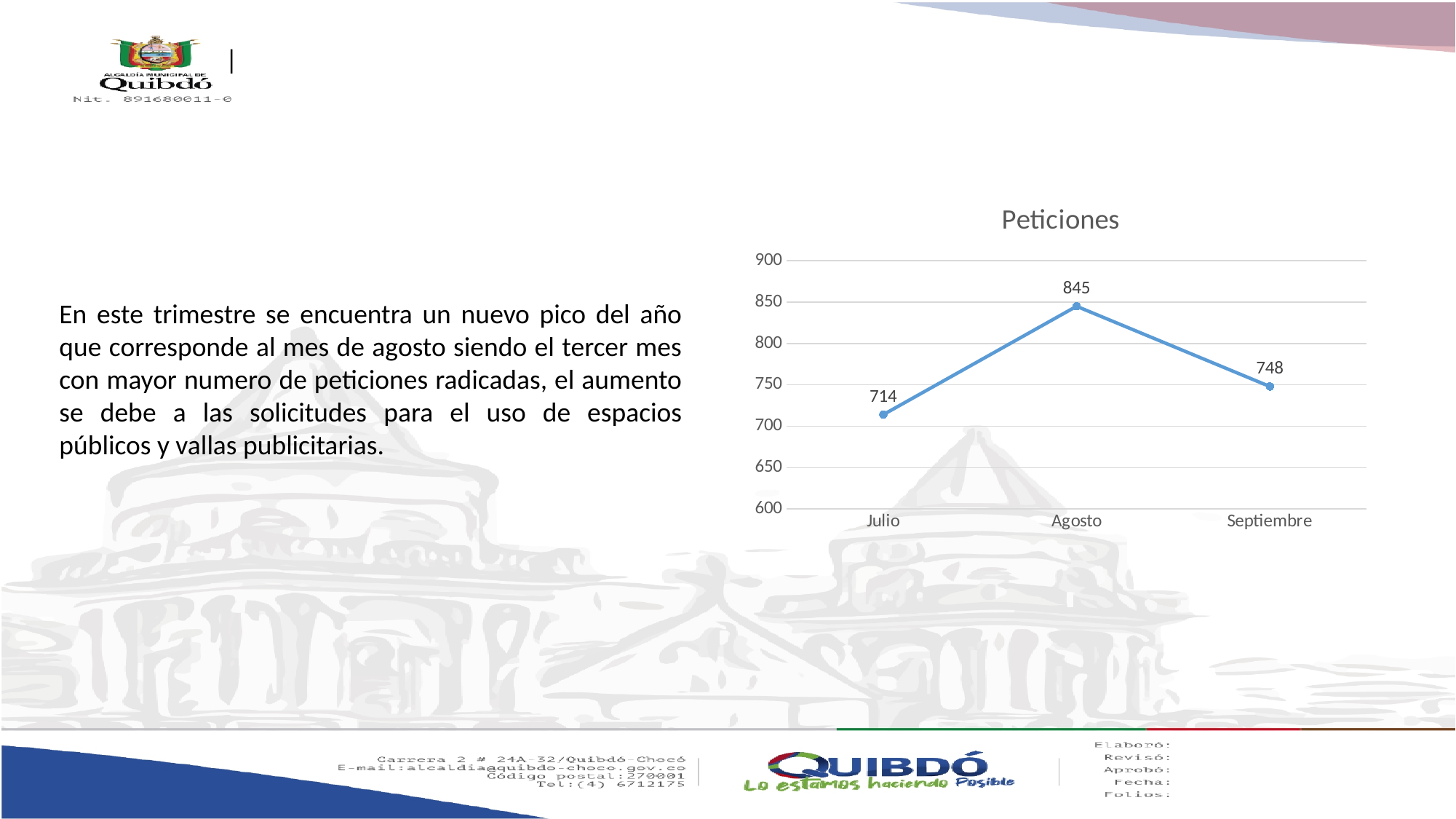
What is the value for Agosto in the Peticiones chart? 845 Which month has the highest value in the Peticiones chart? Agosto What is the value for Septiembre in the Peticiones chart? 748 What is the difference between the values for Agosto and Septiembre? 97 What is the title of the chart? Peticiones Is the value for Agosto greater or less than 800? greater How many months are plotted in the Peticiones chart? 3 What kind of chart is shown on the slide? line chart Which is larger, the value for Septiembre or the value for Julio? Septiembre Which month has the lowest value in the Peticiones chart? Julio What is the difference between the values for Agosto and Julio? 131 What is the value for Julio in the Peticiones chart? 714